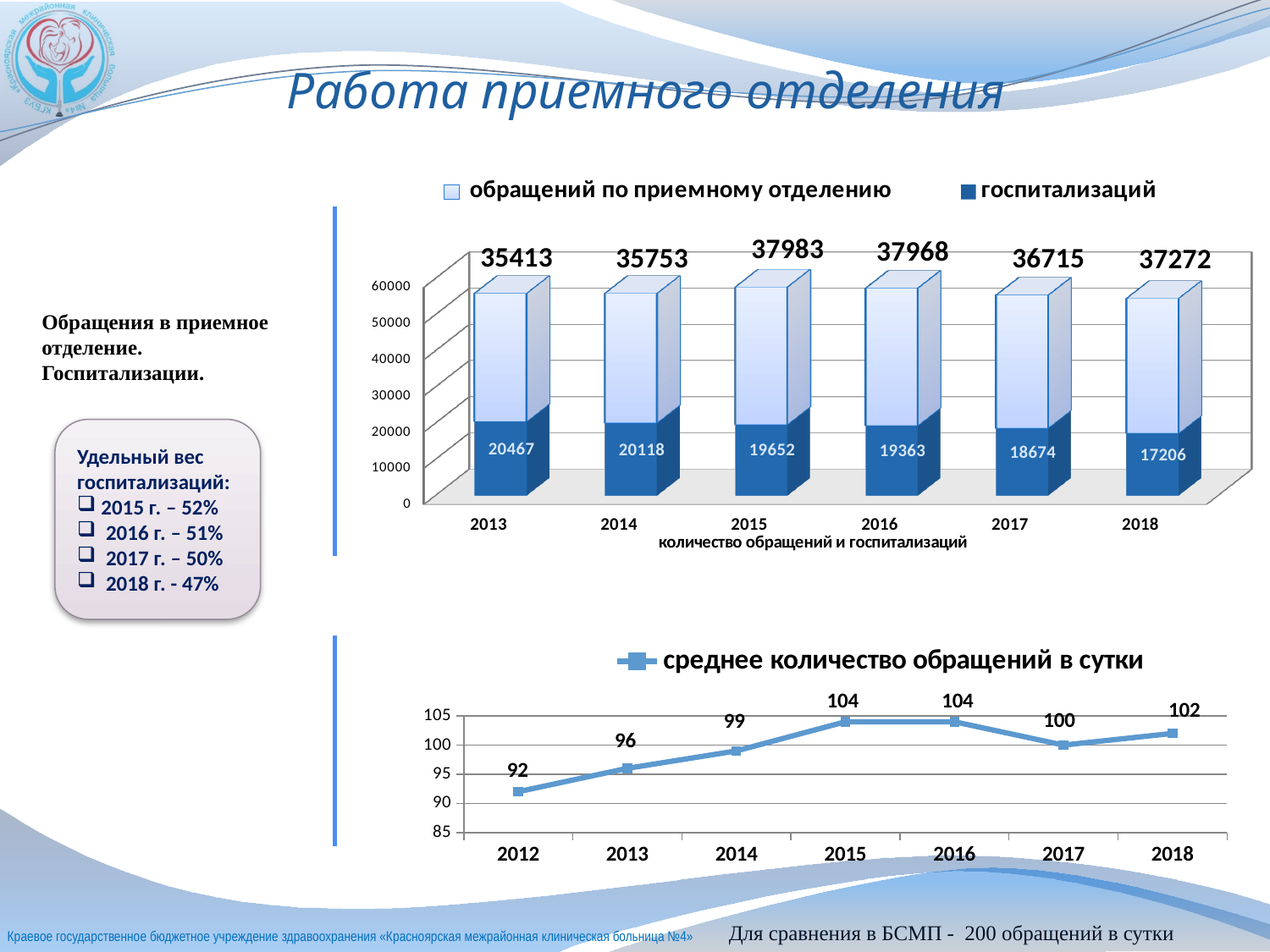
How many series does the legend of the top chart list? 2 In the bottom chart, what is the среднее количество обращений в сутки for 2014? 99 In the top chart, what is the value for обращений по приемному отделению in 2015? 37983 In the bottom chart, how many years are plotted? 7 In the bottom chart, what is the difference between the values for 2015 and 2012? 12 What kind of chart is the top chart? bar chart In the top chart, which year has the lowest value for госпитализаций? 2018 In the top chart, is the value for госпитализаций in 2014 larger or smaller than in 2017? larger In the top chart, what is the difference between обращений по приемному отделению and госпитализаций in 2013? 14946 In the bottom chart, do the values rise or fall from 2012 to 2015? rise In the top chart, which year has the highest value for обращений по приемному отделению? 2015 In the top chart, what is the value for госпитализаций in 2018? 17206